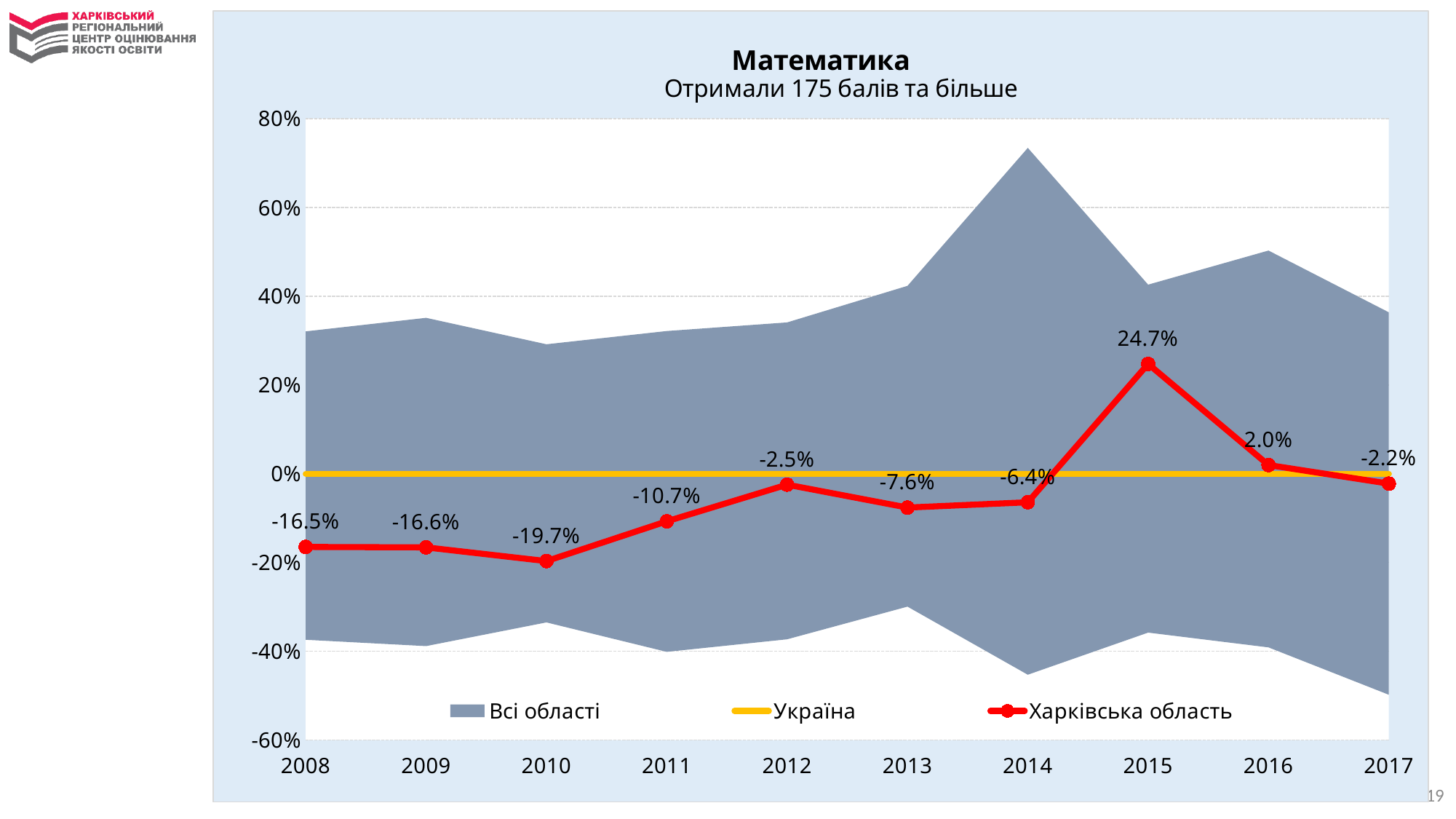
What is the value for Харківська область in 2010? -19.7% What kind of chart is this? line chart with a shaded area Which is larger for Харківська область: the value in 2012 or the value in 2013? 2012 In which year is the value for Харківська область highest? 2015 How many series does the legend list? 3 In which year is the value for Харківська область lowest? 2010 What is the title of the chart? Математика How many years are shown on the x axis? 10 What is the difference between the Харківська область values for 2015 and 2016? 22.7% What is the value for Харківська область in 2017? -2.2% What is the value for Харківська область in 2015? 24.7% Is the value for Харківська область in 2015 greater or less than 20%? greater